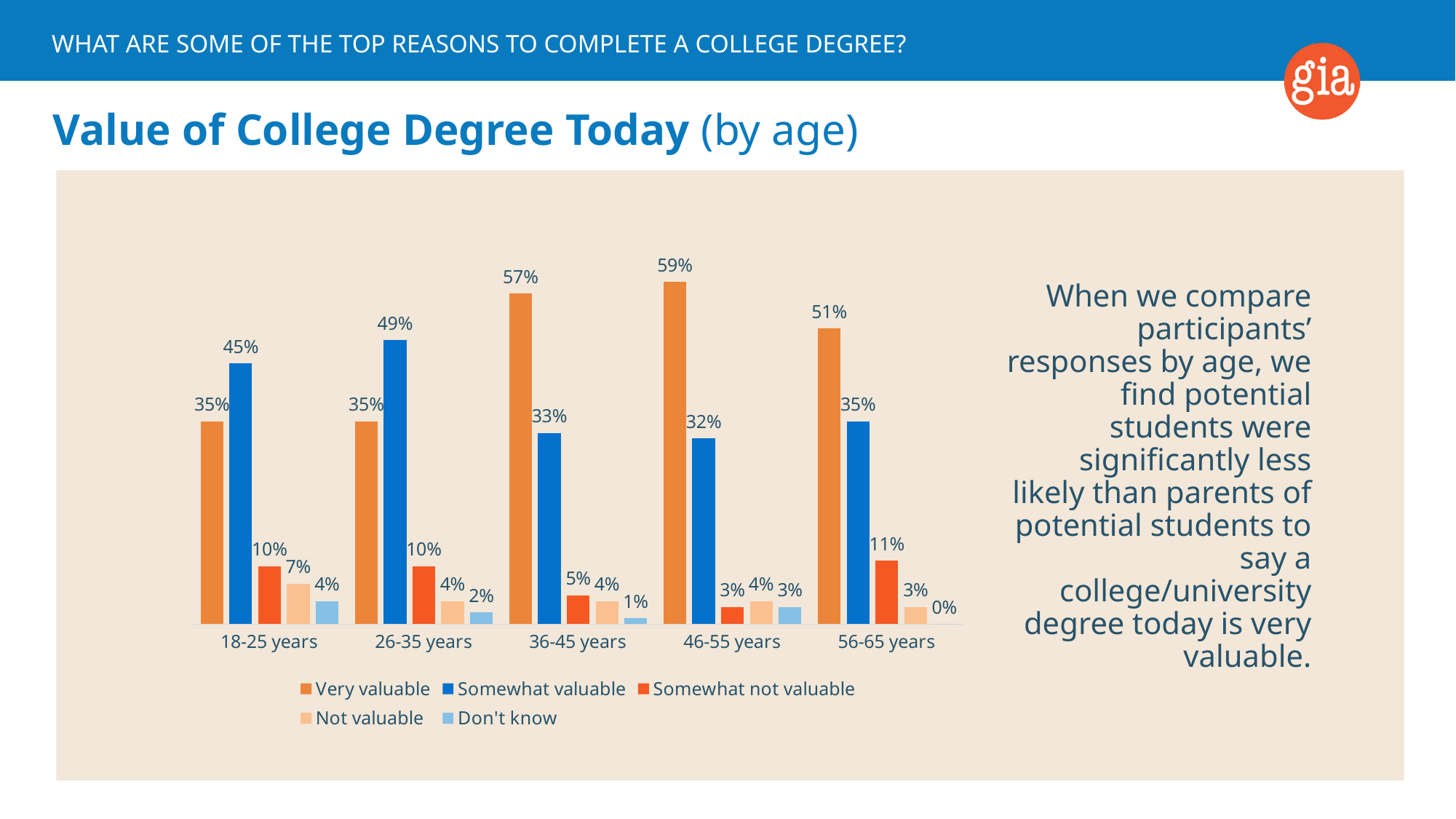
What percentage of 56-65 year olds said a college degree is somewhat not valuable? 11% What is the difference between the 'Very valuable' percentages for 46-55 years and 18-25 years? 24% How many age groups are shown on the x axis? 5 Which age group has the highest 'Very valuable' percentage? 46-55 years Which is larger for 26-35 years: 'Very valuable' or 'Somewhat valuable'? Somewhat valuable What percentage of 18-25 year olds said a college degree is somewhat valuable? 45% What kind of chart is shown on the slide? Bar chart What percentage of 36-45 year olds said a college degree is very valuable? 57% What percentage of 46-55 year olds answered 'Don't know'? 3% What is the title of the chart on the slide? Value of College Degree Today (by age) Which age group has the lowest 'Somewhat valuable' percentage? 46-55 years How many series does the legend list? 5